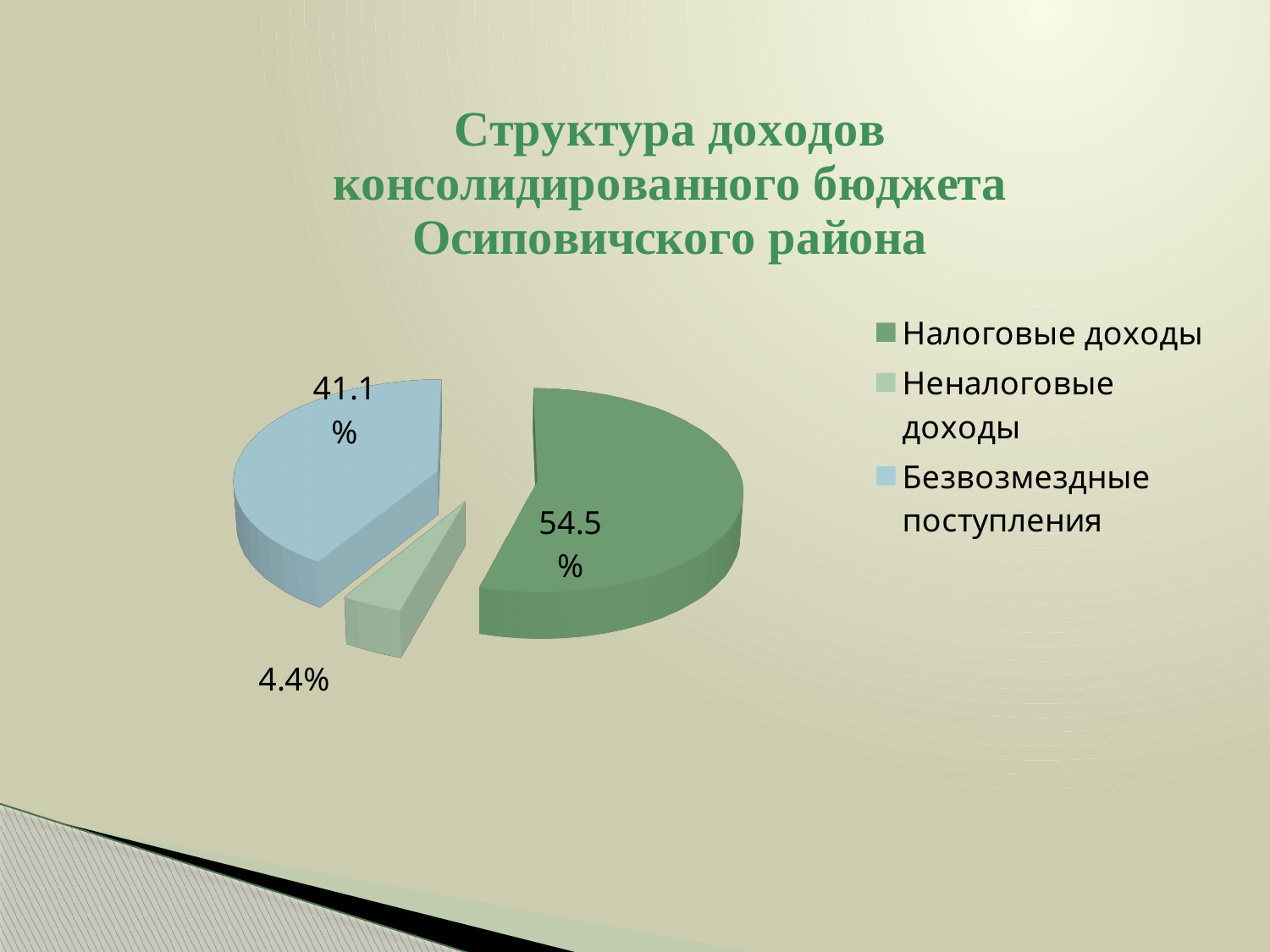
Which is larger: the share of Налоговые доходы or the share of Безвозмездные поступления? Налоговые доходы How many slices does the pie chart have? 3 Which category has the smallest share of the pie? Неналоговые доходы What kind of chart is shown on the slide? Pie chart How many entries does the legend list? 3 What share of the pie does Налоговые доходы have? 54.5% What is the difference between the shares of Безвозмездные поступления and Неналоговые доходы? 36.7% What share of the pie does Безвозмездные поступления have? 41.1% What is the difference between the shares of Налоговые доходы and Безвозмездные поступления? 13.4% Which category has the largest share of the pie? Налоговые доходы What share of the pie does Неналоговые доходы have? 4.4% What colour is the slice for Безвозмездные поступления? Light blue